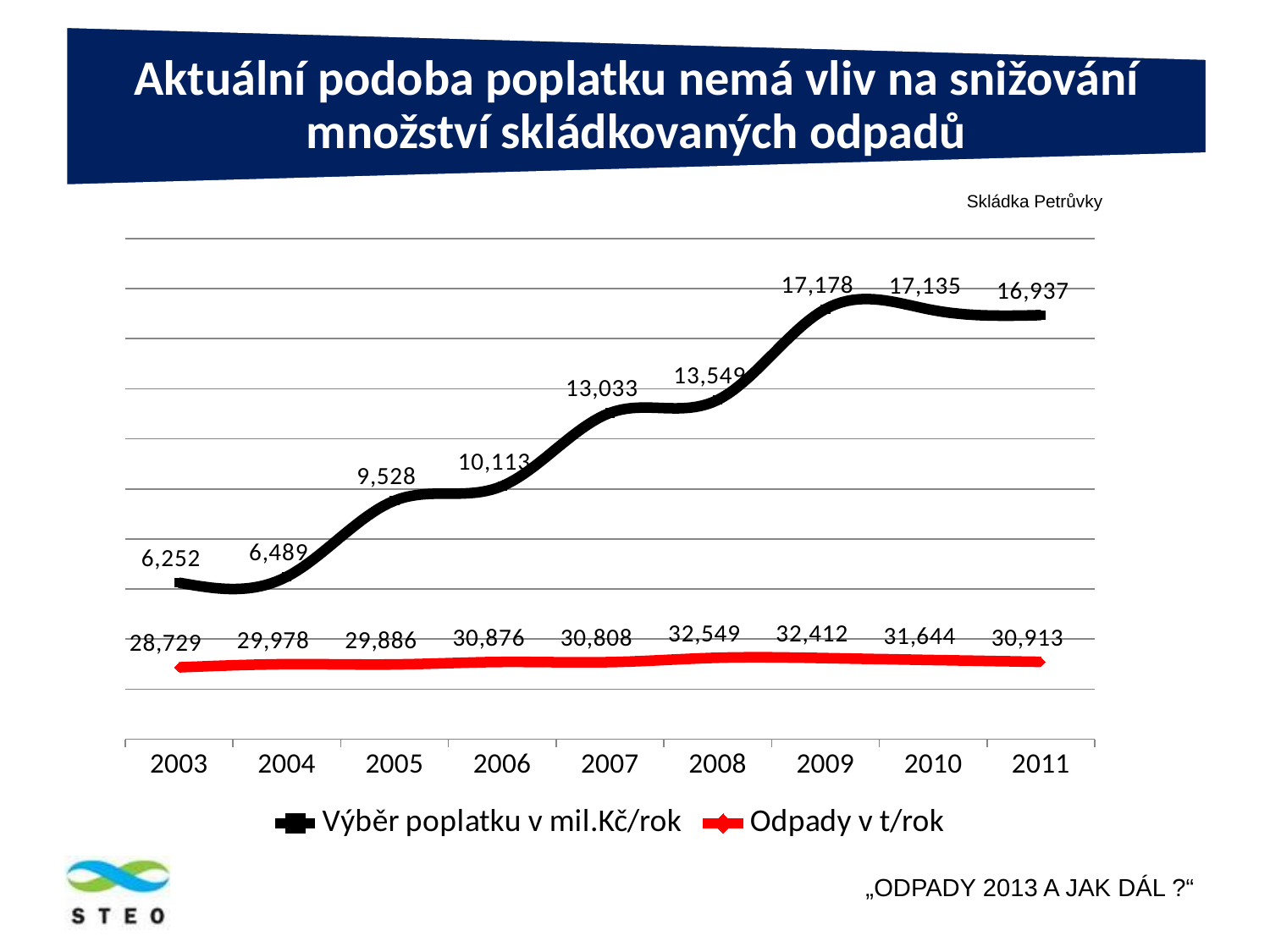
What kind of chart is shown on the slide? line chart In which year is Odpady v t/rok highest? 2008 What is the value of Výběr poplatku v mil.Kč/rok in 2007? 13,033 In which year is Odpady v t/rok lowest? 2003 How many series does the legend list? 2 In which year is Výběr poplatku v mil.Kč/rok highest? 2009 What is the value of Odpady v t/rok in 2010? 31,644 What is the difference between Výběr poplatku v mil.Kč/rok in 2009 and in 2003? 10,926 What is the value of Výběr poplatku v mil.Kč/rok in 2003? 6,252 What is the difference between Odpady v t/rok in 2008 and in 2003? 3,820 Which is larger: Výběr poplatku v mil.Kč/rok in 2005 or in 2006? 2006 How many years are shown on the x axis? 9